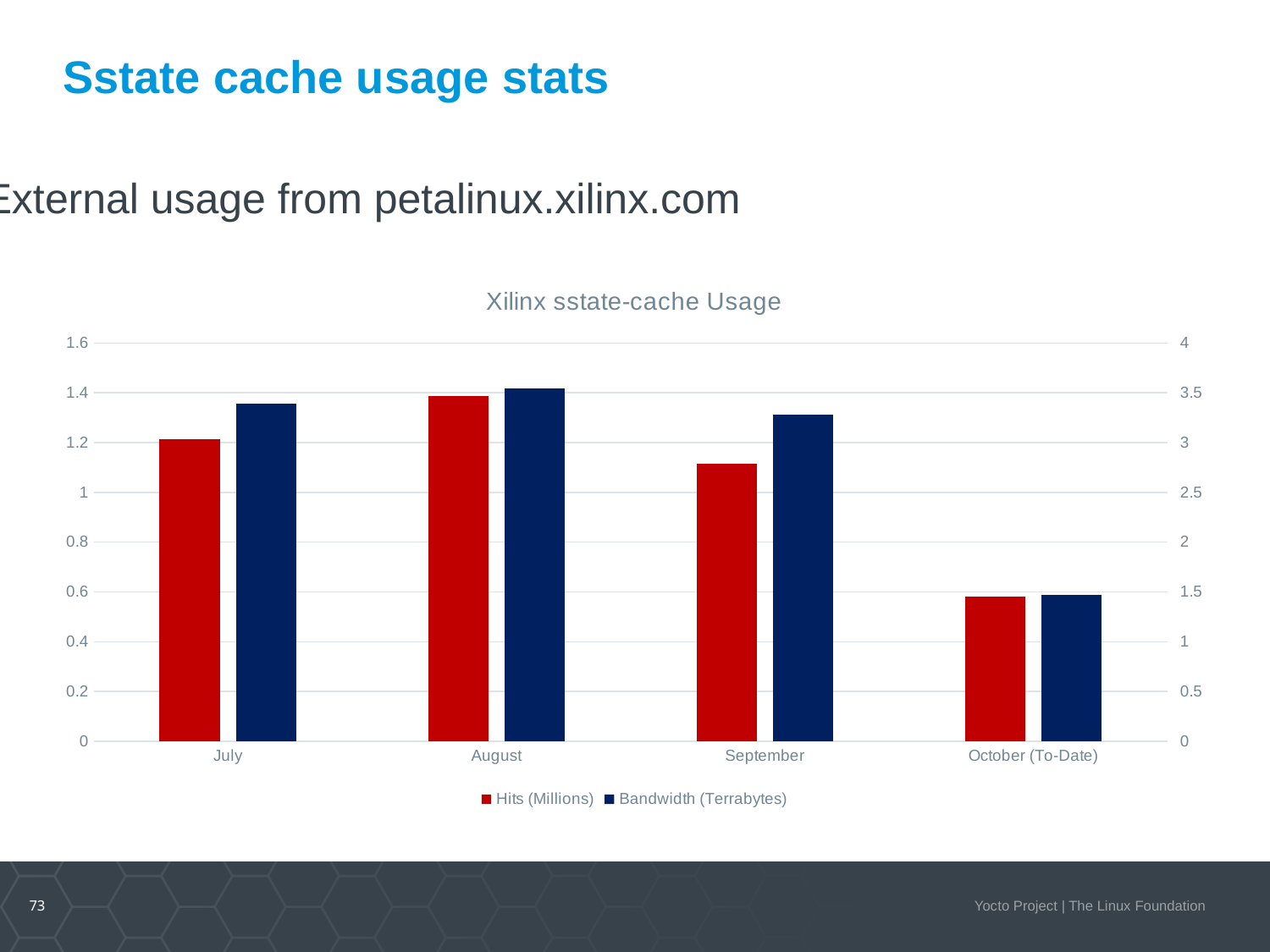
Is the value for Hits (Millions) in October (To-Date) greater or less than 0.8? less Do the Hits (Millions) values rise or fall from August to October (To-Date)? fall Which colour represents Bandwidth (Terrabytes) in the legend? dark blue What kind of chart is shown on the slide? bar chart What is the title of the chart? Xilinx sstate-cache Usage How many months (categories) are shown on the x axis? 4 Is the value for Bandwidth (Terrabytes) in July greater or less than 3 on the right-hand axis? greater Which is larger, Hits (Millions) for July or for September? July How many series does the chart legend list? 2 Is the value for Hits (Millions) in August greater or less than 1.2? greater Which month has the lowest value for Bandwidth (Terrabytes)? October (To-Date) Which month has the highest value for Hits (Millions)? August